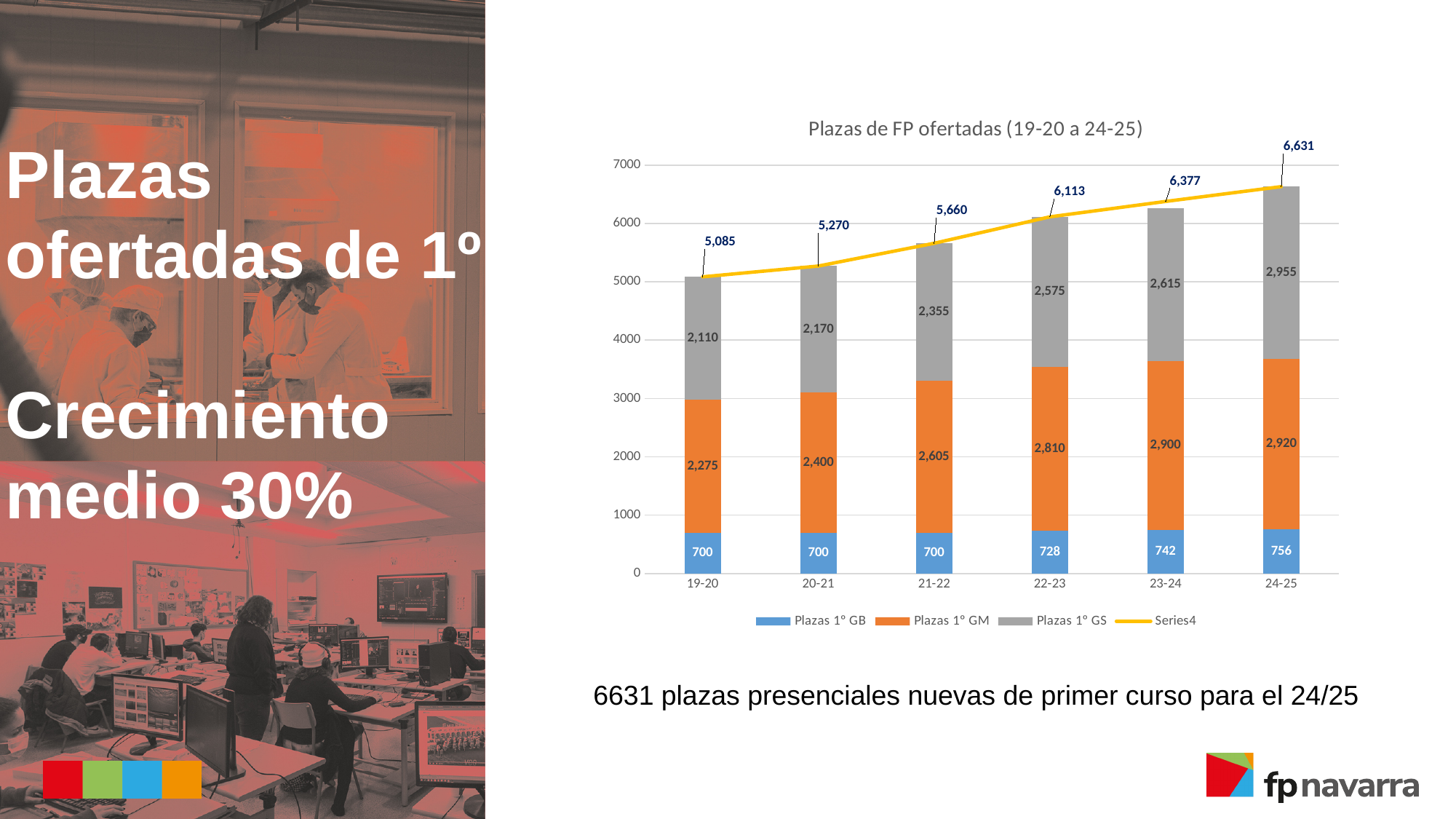
Which year has the highest total of plazas ofertadas? 24-25 What is the value for Plazas 1º GS in 24-25? 2,955 What is the value for Plazas 1º GM in 21-22? 2,605 Which is larger, Plazas 1º GM in 22-23 or Plazas 1º GS in 22-23? Plazas 1º GM in 22-23 What kind of chart is shown on the slide? Stacked bar chart with a line Which year has the lowest value for Plazas 1º GS? 19-20 What is the difference between the totals for 24-25 and 19-20? 1,546 How many years (categories) are shown on the x axis? 6 What is the total of the stacked bar for 23-24? 6,377 How many series does the legend list? 4 What is the value for Plazas 1º GB in 22-23? 728 Do the total plazas ofertadas rise or fall from 19-20 to 24-25? Rise